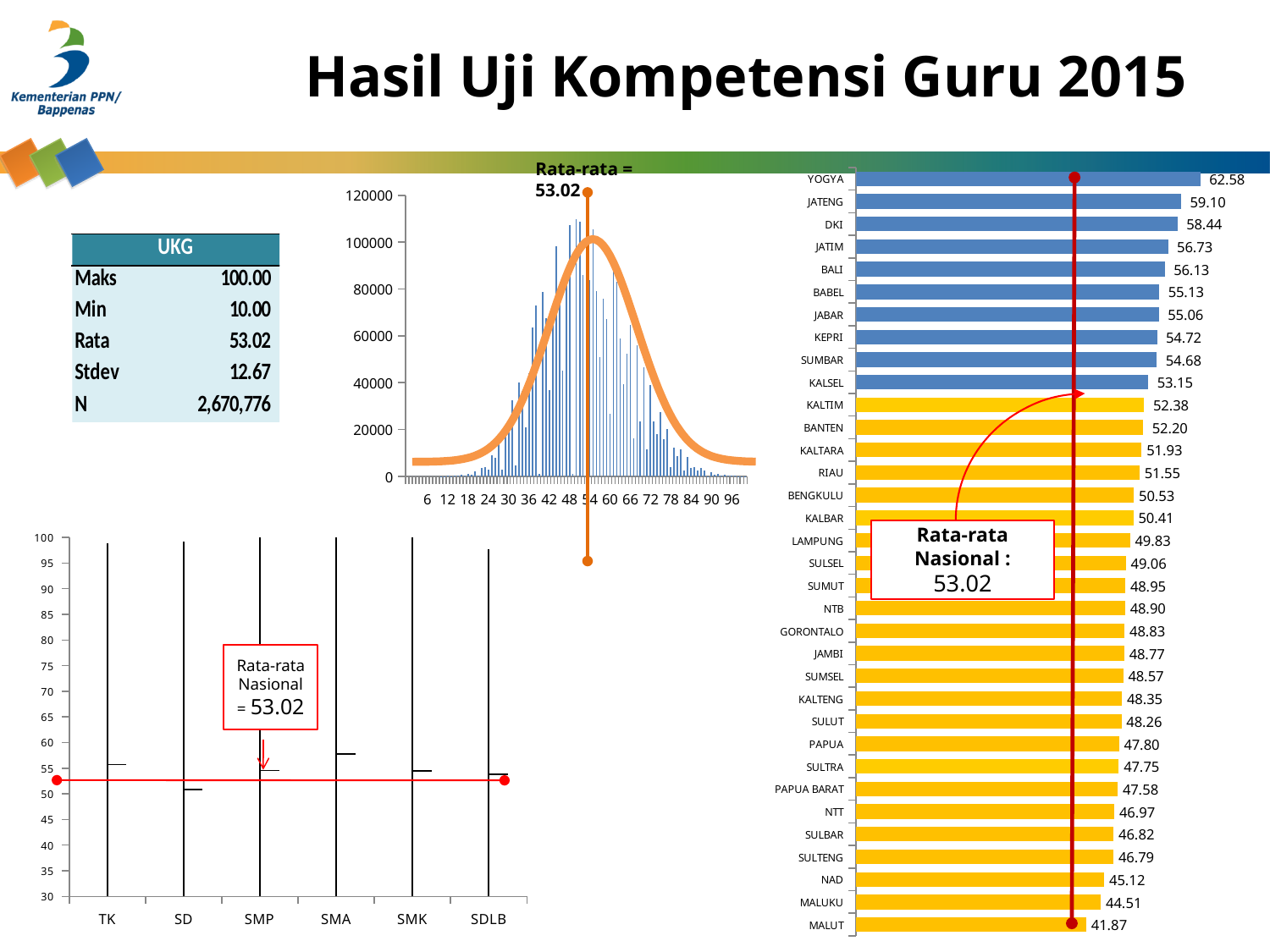
In the horizontal bar chart of provinces on the right, which province has the highest value? YOGYA In the horizontal bar chart of provinces on the right, what is the difference between the values for YOGYA and MALUT? 20.71 In the histogram in the centre of the slide, is the value at 6 on the x axis greater or less than 20000? less In the horizontal bar chart of provinces on the right, which has the larger value, BALI or BABEL? BALI In the horizontal bar chart of provinces on the right, what is the value for KALSEL? 53.15 In the horizontal bar chart of provinces on the right, what is the value for PAPUA BARAT? 47.58 In the horizontal bar chart of provinces on the right, what national average (Rata-rata Nasional) is marked by the red line? 53.02 In the horizontal bar chart of provinces on the right, which province has the lowest value? MALUT In the bottom-left chart, how many school-level categories are shown on the x axis? 6 What kind of chart is the chart of provinces on the right side of the slide? Bar chart In the horizontal bar chart of provinces on the right, what is the value for JATIM? 56.73 In the horizontal bar chart of provinces on the right, how many provinces are shown? 34